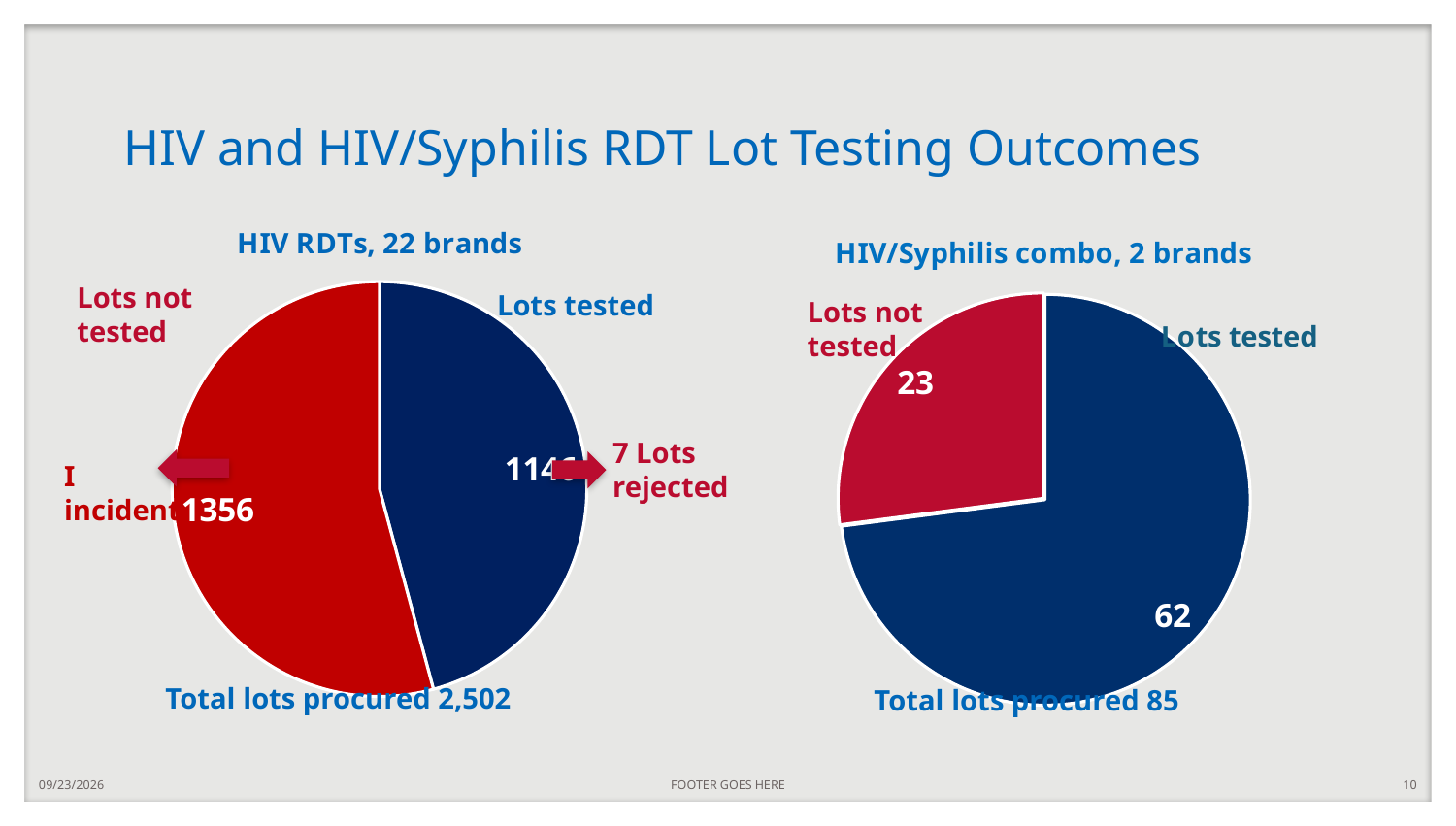
In the HIV/Syphilis combo, 2 brands chart, which is larger: lots tested or lots not tested? Lots tested In the HIV RDTs, 22 brands chart, how many lots were not tested? 1356 What is the total number of lots procured shown for the HIV/Syphilis combo, 2 brands chart? 85 In the HIV/Syphilis combo, 2 brands chart, which slice is the largest? Lots tested How many slices does the HIV RDTs, 22 brands pie chart have? 2 In the HIV/Syphilis combo, 2 brands chart, what is the difference between lots tested and lots not tested? 39 In the HIV RDTs, 22 brands chart, which slice is the largest? Lots not tested According to the annotation on the HIV RDTs, 22 brands chart, how many lots were rejected? 7 What type of chart is used on this slide? Pie chart What is the total number of lots procured shown for the HIV RDTs, 22 brands chart? 2,502 In the HIV/Syphilis combo, 2 brands chart, how many lots were not tested? 23 In the HIV/Syphilis combo, 2 brands chart, how many lots were tested? 62